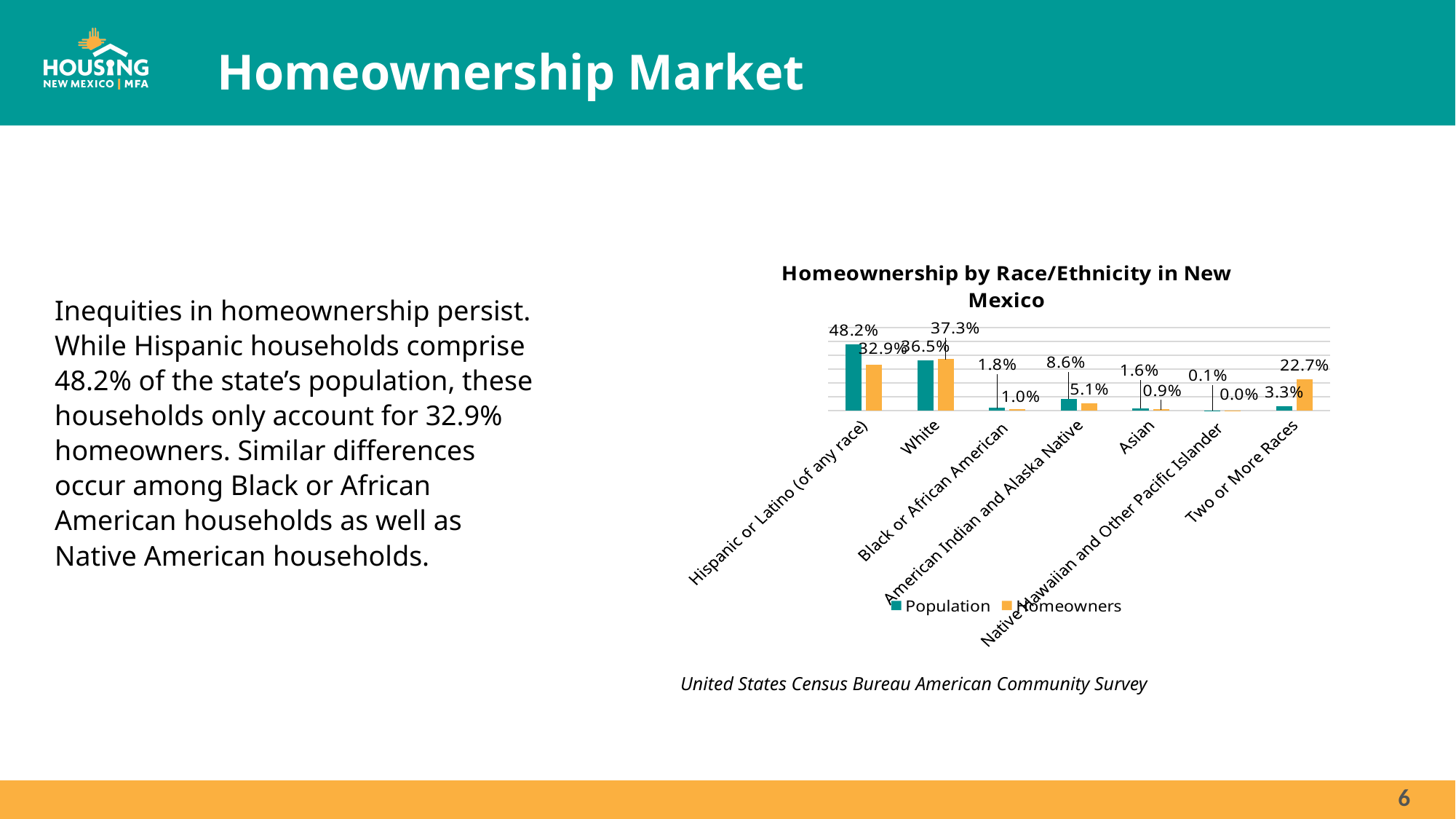
Which is larger for Two or More Races, the Population value or the Homeowners value? Homeowners What is the Homeowners value for Two or More Races? 22.7% What is the Population value for Asian? 1.6% What is the Population value for Hispanic or Latino (of any race)? 48.2% Which category has the highest Population value? Hispanic or Latino (of any race) What kind of chart is shown on the slide? Bar chart What is the title of the chart? Homeownership by Race/Ethnicity in New Mexico Which category has the lowest Homeowners value? Native Hawaiian and Other Pacific Islander How many series does the legend list? 2 What is the difference between the Population and Homeowners values for Hispanic or Latino (of any race)? 15.3% How many race/ethnicity categories are shown on the x axis? 7 What is the Homeowners value for American Indian and Alaska Native? 5.1%